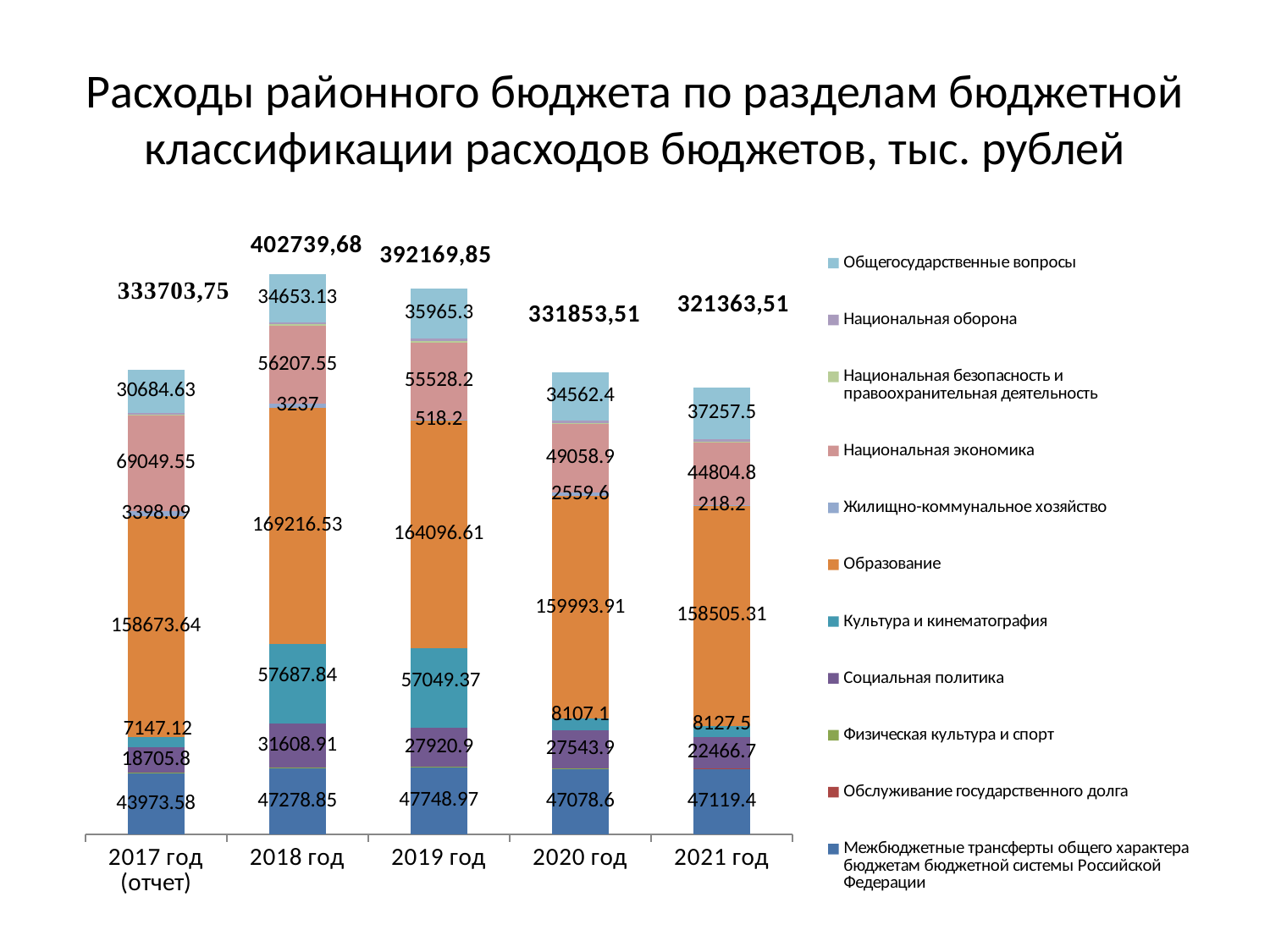
How many years (categories) are shown on the x axis? 5 What kind of chart is shown on the slide? stacked bar chart Which is larger: Культура и кинематография in 2018 год or in 2020 год? 2018 год What is the difference between the Образование values for 2018 год and 2017 год (отчет)? 10542.89 How many series does the legend list? 11 Do the values for Национальная экономика rise or fall from 2017 год (отчет) to 2021 год? fall What is the value for Национальная экономика in 2017 год (отчет)? 69049.55 What is the value for Образование in 2019 год? 164096.61 What is the value for Общегосударственные вопросы in 2021 год? 37257.5 Which year has the lowest total expenditure? 2021 год Which year has the highest total expenditure? 2018 год What is the total expenditure shown above the bar for 2018 год? 402739,68